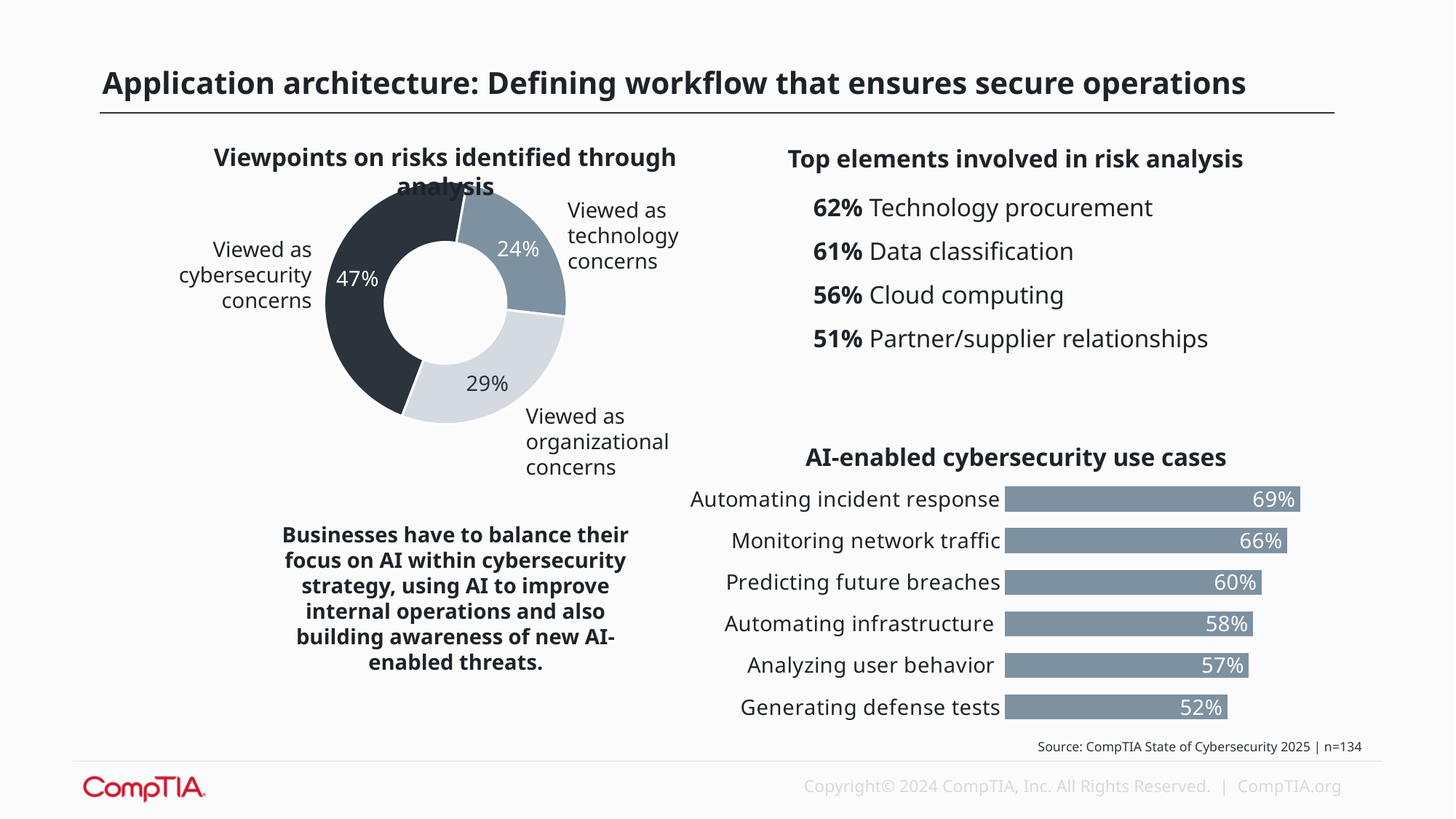
In the 'Viewpoints on risks identified through analysis' chart, which viewpoint has the largest share? Viewed as cybersecurity concerns In the 'Viewpoints on risks identified through analysis' chart, what share of respondents viewed risks as technology concerns? 24% In the 'Viewpoints on risks identified through analysis' chart, what share of respondents viewed risks as cybersecurity concerns? 47% In the 'Viewpoints on risks identified through analysis' chart, which viewpoint has the smallest share? Viewed as technology concerns In the 'AI-enabled cybersecurity use cases' chart, what is the value for Predicting future breaches? 60% In the 'AI-enabled cybersecurity use cases' chart, what is the difference between Automating incident response and Generating defense tests? 17% What kind of chart is 'Viewpoints on risks identified through analysis'? Donut chart In the 'AI-enabled cybersecurity use cases' chart, which use case has the lowest value? Generating defense tests How many use cases are shown in the 'AI-enabled cybersecurity use cases' chart? 6 In the 'Viewpoints on risks identified through analysis' chart, what is the difference between the share for organizational concerns and the share for technology concerns? 5% What kind of chart is 'AI-enabled cybersecurity use cases'? Bar chart In the 'AI-enabled cybersecurity use cases' chart, which use case has the highest value? Automating incident response